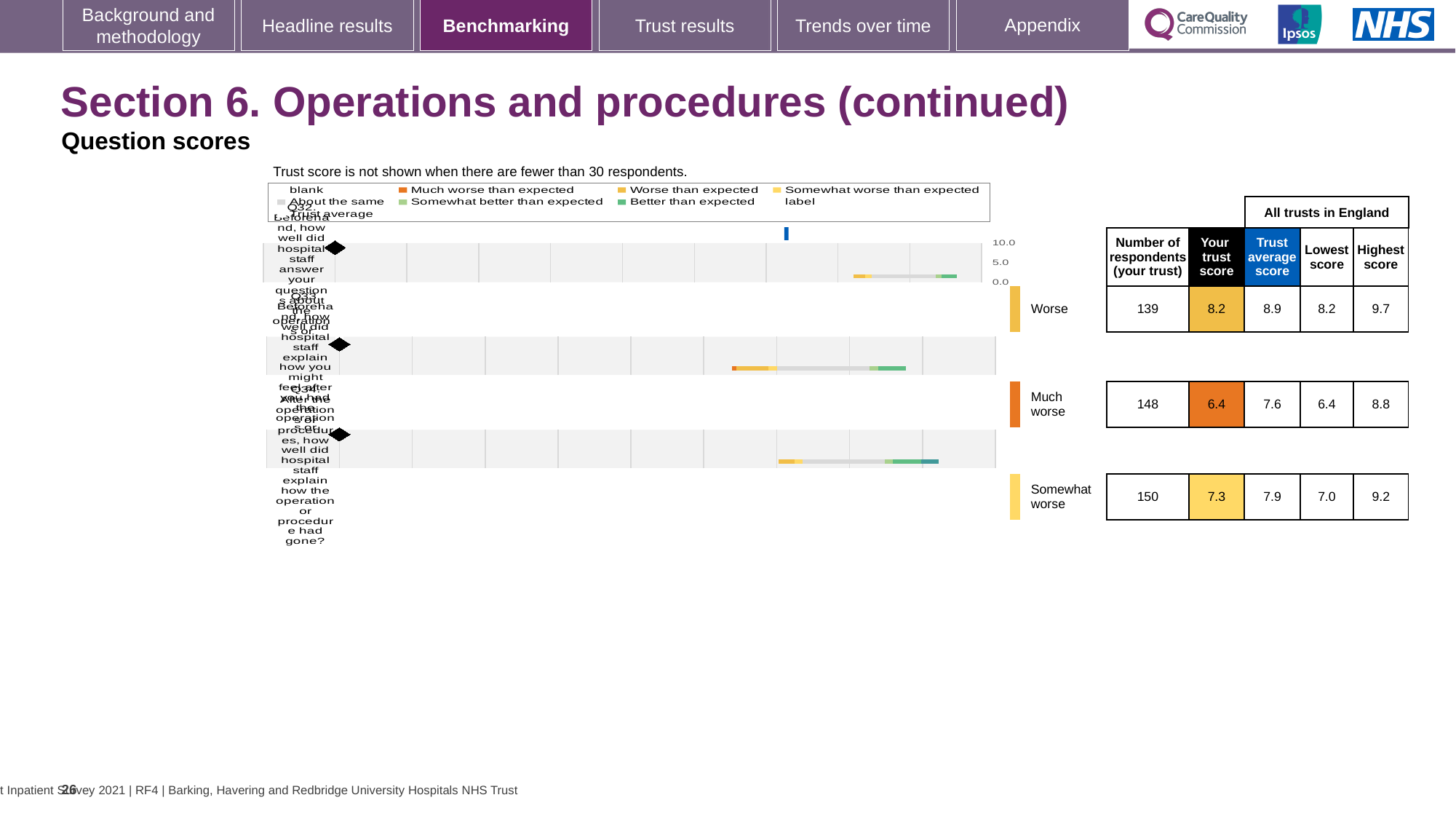
How many question rows are plotted in the chart? 3 How many respondents are shown for the row rated 'Much worse'? 148 Which row has the larger highest score across all trusts in England: 'Worse' or 'Somewhat worse'? Worse What is the 'Your trust score' for the row rated 'Worse'? 8.2 What is the lowest score across all trusts in England for the row rated 'Somewhat worse'? 7.0 Which row has the lowest 'Your trust score'? Much worse For the row rated 'Much worse', what is the difference between the trust average score and your trust score? 1.2 For the row rated 'Worse', what is the difference between the highest score and the lowest score across all trusts in England? 1.5 What kind of chart is shown on the slide? bar chart Which row has the highest 'Your trust score'? Worse What is the trust average score for the row rated 'Somewhat worse'? 7.9 What colour does the legend use for 'Much worse than expected'? orange